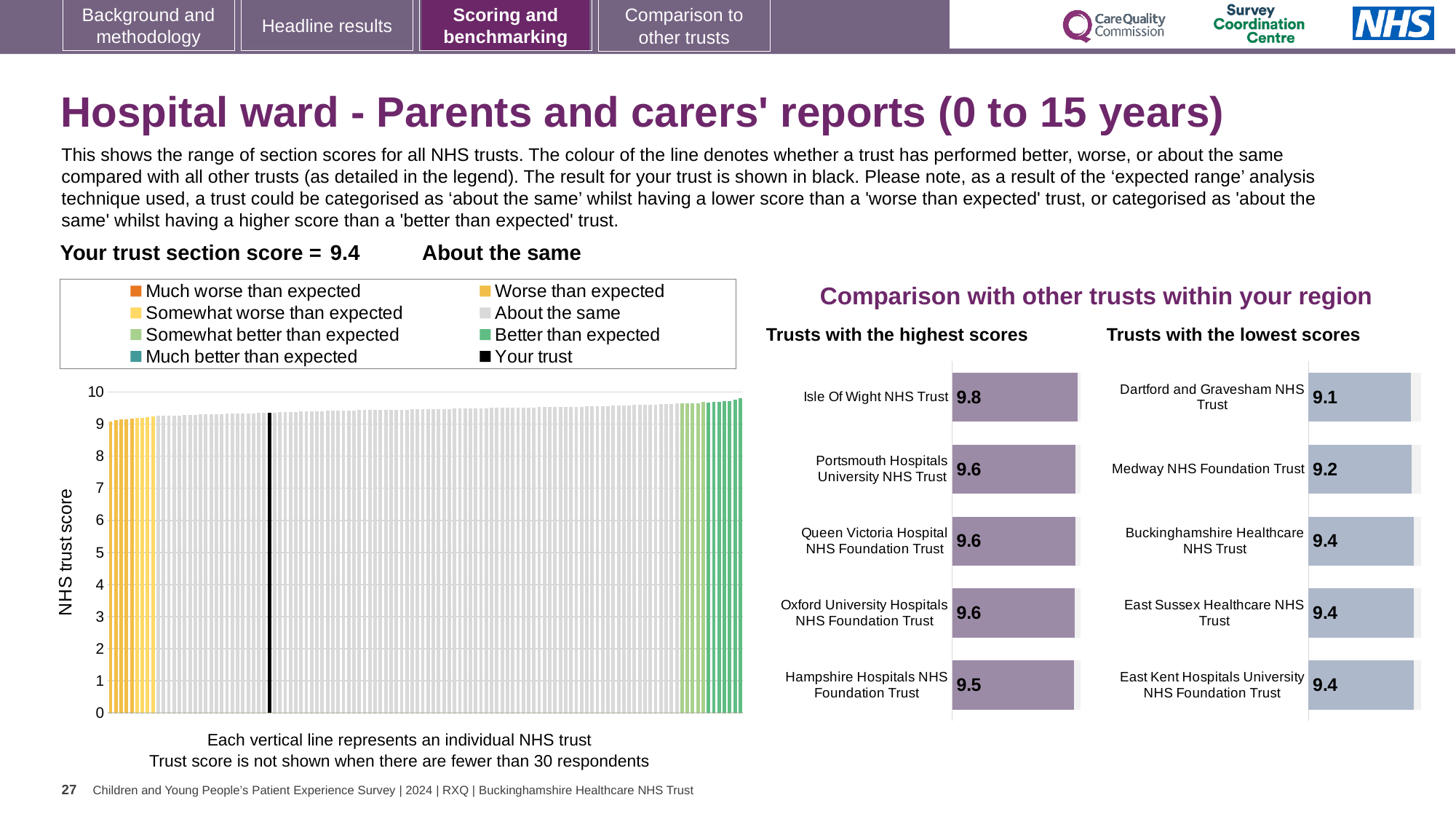
In the 'Trusts with the highest scores' chart, which trust has the highest score? Isle Of Wight NHS Trust In the large chart on the left, what is the section score for your trust (shown in black)? 9.4 In the 'Trusts with the lowest scores' chart, which trust has the lowest score? Dartford and Gravesham NHS Trust What kind of chart is the large chart on the left showing NHS trust scores? bar chart In the 'Trusts with the lowest scores' chart, what is the difference between the scores of Buckinghamshire Healthcare NHS Trust and Dartford and Gravesham NHS Trust? 0.3 In the 'Trusts with the highest scores' chart, what is the score for Isle Of Wight NHS Trust? 9.8 How many trusts are listed in the 'Trusts with the highest scores' chart? 5 In the 'Trusts with the lowest scores' chart, which has the larger score: Medway NHS Foundation Trust or Dartford and Gravesham NHS Trust? Medway NHS Foundation Trust How many entries does the legend of the large chart on the left list? 8 How many trusts are listed in the 'Trusts with the lowest scores' chart? 5 In the 'Trusts with the highest scores' chart, what is the difference between the scores of Isle Of Wight NHS Trust and Hampshire Hospitals NHS Foundation Trust? 0.3 In the 'Trusts with the lowest scores' chart, what is the score for Medway NHS Foundation Trust? 9.2